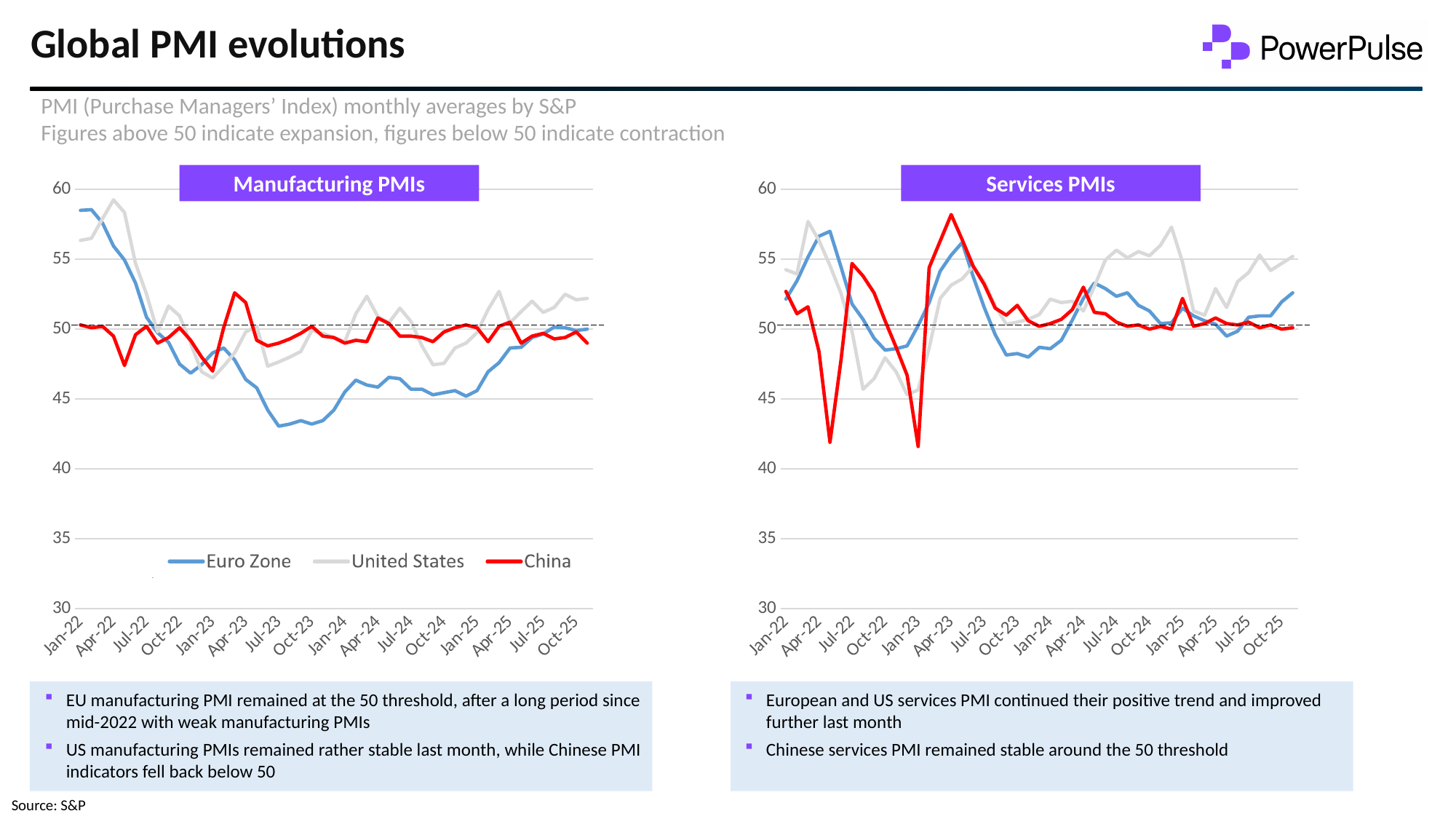
In the Manufacturing PMIs chart, does the Euro Zone line rise or fall from Jan-22 to Jul-23? fall What kind of chart is the Manufacturing PMIs chart? line chart How many series does the legend list for the PMI charts? 3 In the Services PMIs chart, is the China value at Jan-23 greater or less than 45? less In the Manufacturing PMIs chart, which is larger at Jul-23: the United States or the Euro Zone value? United States In the Services PMIs chart, which is larger at Jan-23: the Euro Zone or the China value? Euro Zone In the Manufacturing PMIs chart, what colour is the China line? red In the Manufacturing PMIs chart, is the Euro Zone value at Jul-23 greater or less than 45? less In the Manufacturing PMIs chart, is the Euro Zone value at Jan-22 greater or less than 55? greater Which series are shown in the legend of the Manufacturing PMIs chart? Euro Zone, United States, China In the Manufacturing PMIs chart, which series reaches the lowest value over the period? Euro Zone